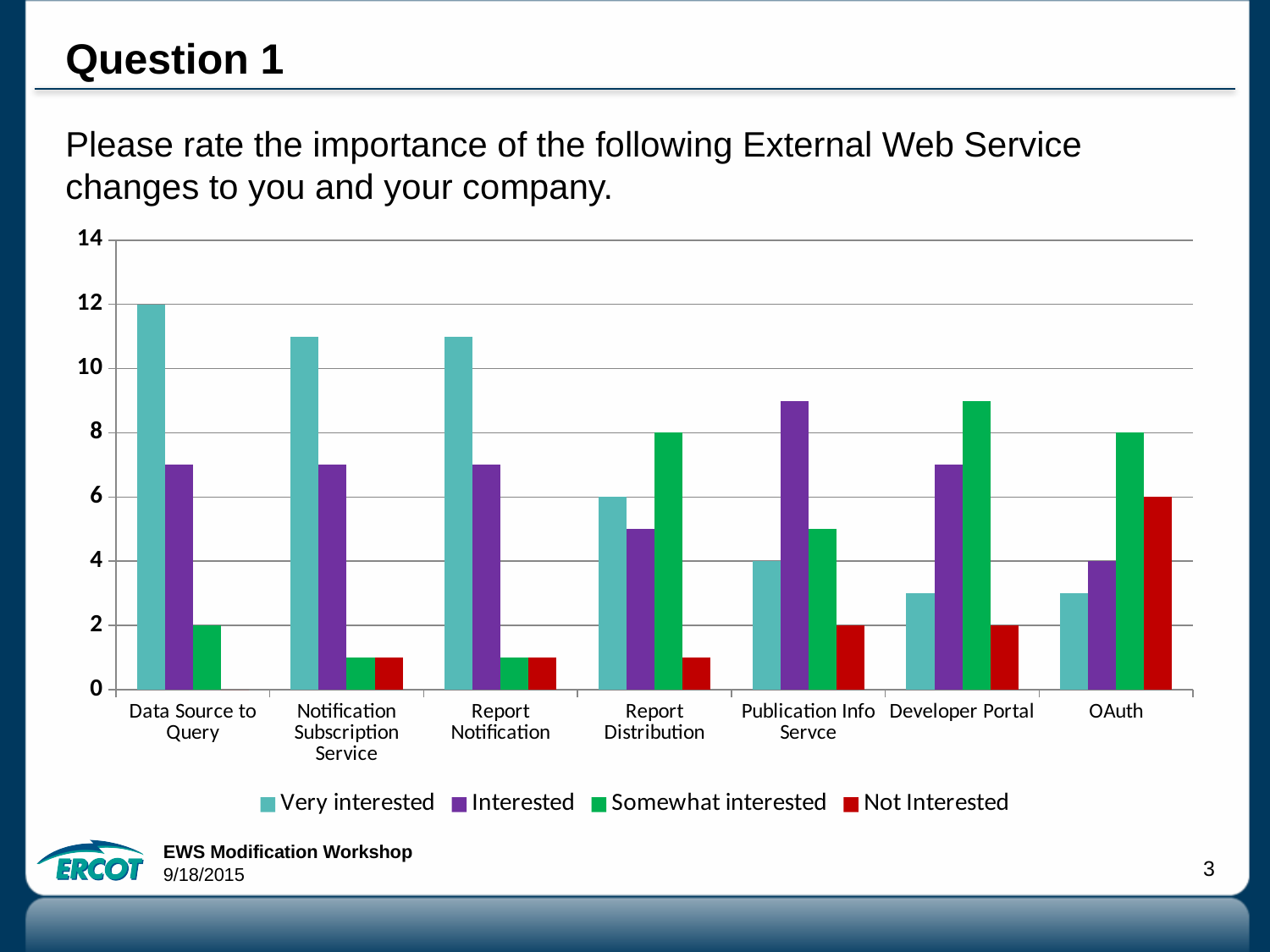
Is the Very interested value for Developer Portal greater or less than 4? less How many categories are shown on the x axis? 7 How many series does the legend list? 4 What is the difference between the Very interested and Somewhat interested values for Data Source to Query? 10 Which category has the highest Not Interested value? OAuth What is the Not Interested value for OAuth? 6 Which category has the highest Very interested value? Data Source to Query Which is larger for Report Distribution: the Very interested value or the Somewhat interested value? Somewhat interested What is the Very interested value for Data Source to Query? 12 Is the Interested value for Publication Info Servce greater or less than 8? greater What is the Somewhat interested value for Report Distribution? 8 What kind of chart is shown on the slide? bar chart